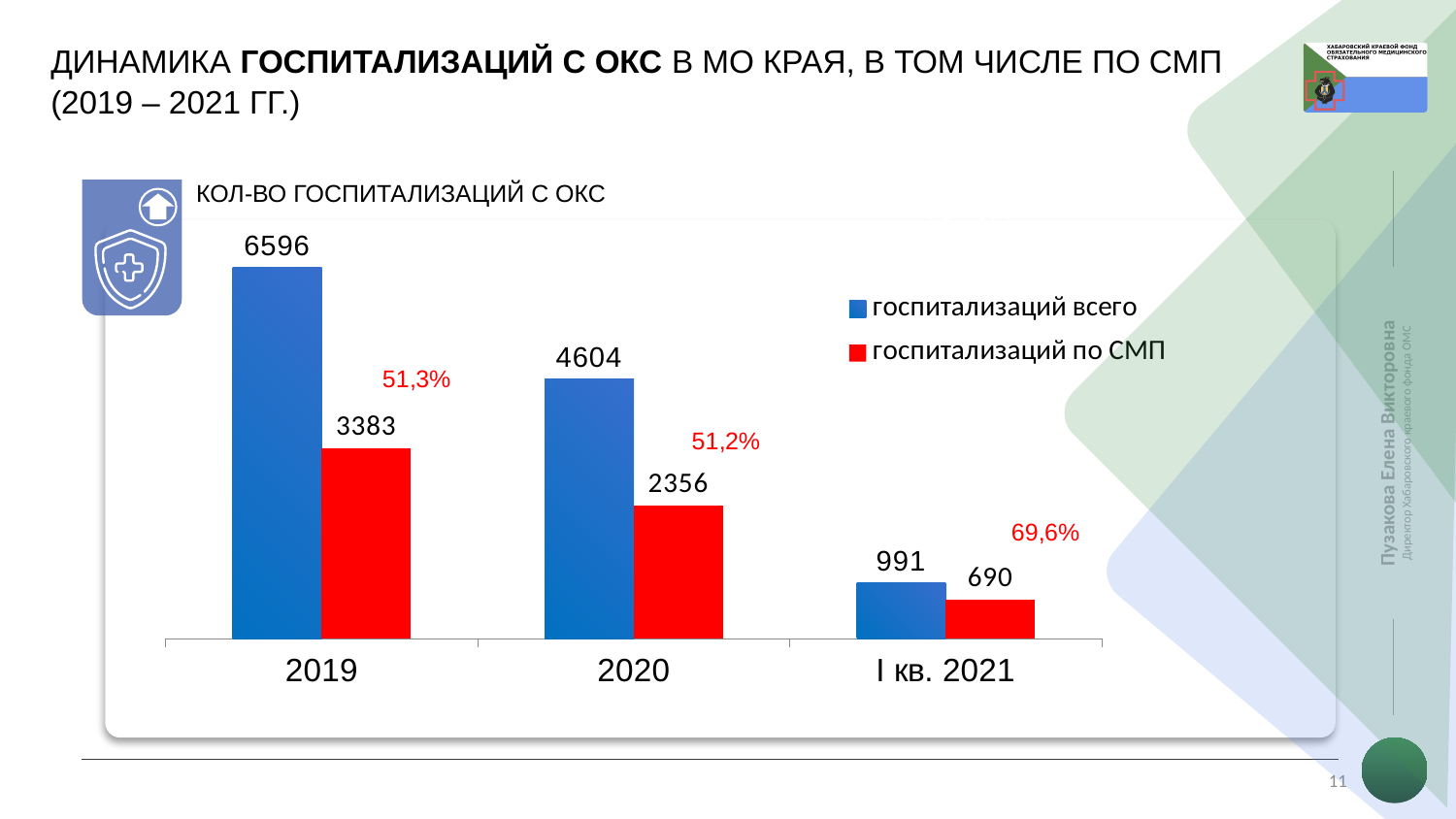
What percentage is shown for I кв. 2021? 69,6% What is the difference between "госпитализаций всего" and "госпитализаций по СМП" in 2020? 2248 How many series does the legend list? 2 What percentage is shown above the red bar for 2019? 51,3% What is the value for "госпитализаций по СМП" in 2020? 2356 What is the value for "госпитализаций по СМП" in I кв. 2021? 690 What kind of chart is shown on the slide? bar chart Which category has the lowest value for "госпитализаций по СМП"? I кв. 2021 Which is larger: "госпитализаций всего" in 2020 or "госпитализаций по СМП" in 2019? госпитализаций всего in 2020 How many categories are shown on the x axis? 3 Which category has the highest value for "госпитализаций всего"? 2019 What is the value for "госпитализаций всего" in 2019? 6596